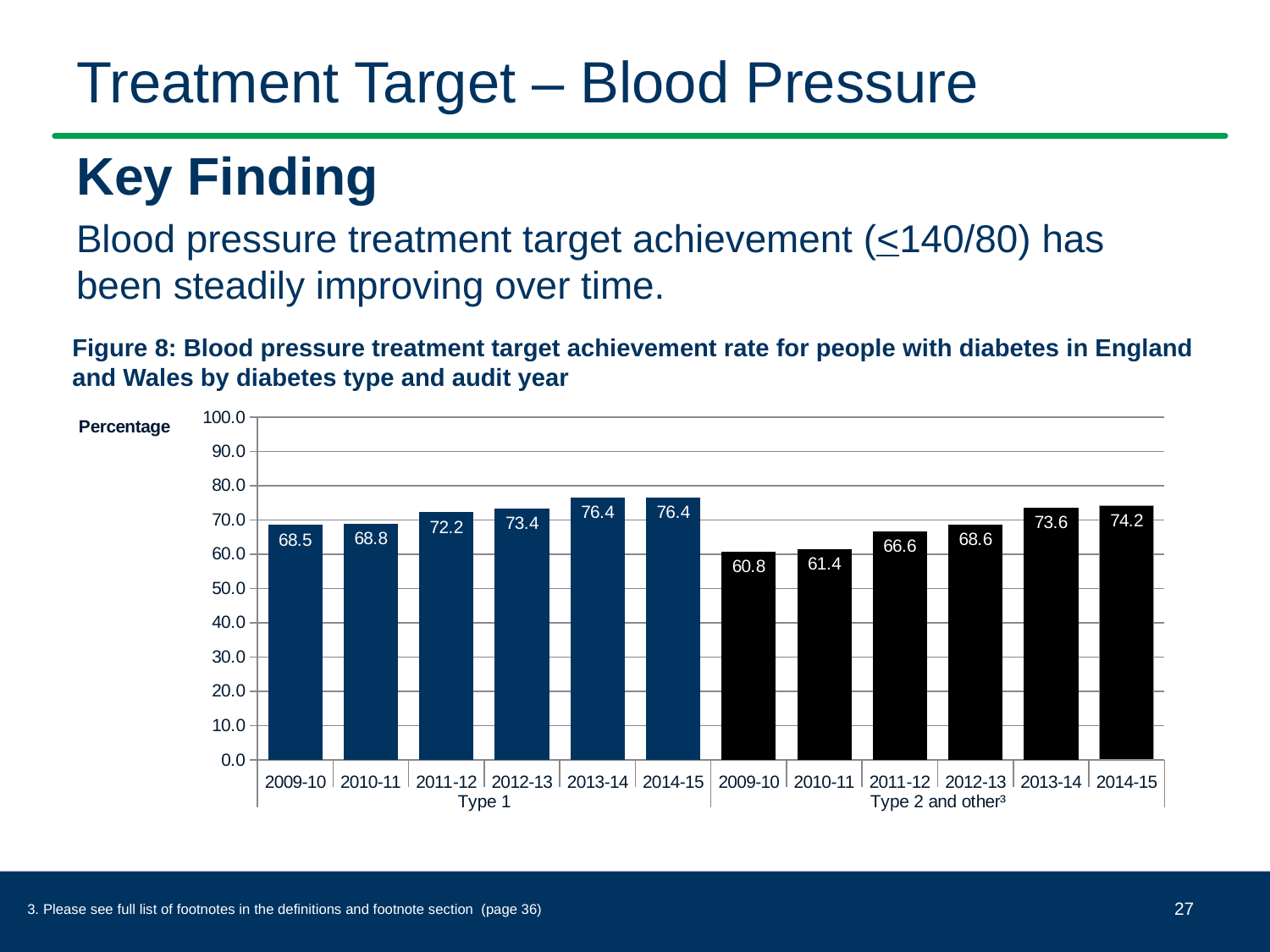
What is the difference between the Type 1 value in 2014-15 and the Type 1 value in 2009-10? 7.9 What is the value for Type 2 and other in 2012-13? 68.6 What is the value for Type 2 and other in 2009-10? 60.8 Which is larger in 2013-14: the Type 1 value or the Type 2 and other value? Type 1 What is the blood pressure treatment target achievement rate for Type 1 in 2014-15? 76.4 Which audit year has the lowest value for Type 1? 2009-10 What kind of chart is shown on the slide? Bar chart How many bars are plotted in the chart? 12 Do the Type 2 and other values rise or fall from 2009-10 to 2014-15? Rise Is the value for Type 2 and other in 2010-11 greater or less than 70.0? less What is the difference between the Type 1 and Type 2 and other values in 2011-12? 5.6 Which audit year has the highest value for Type 2 and other? 2014-15